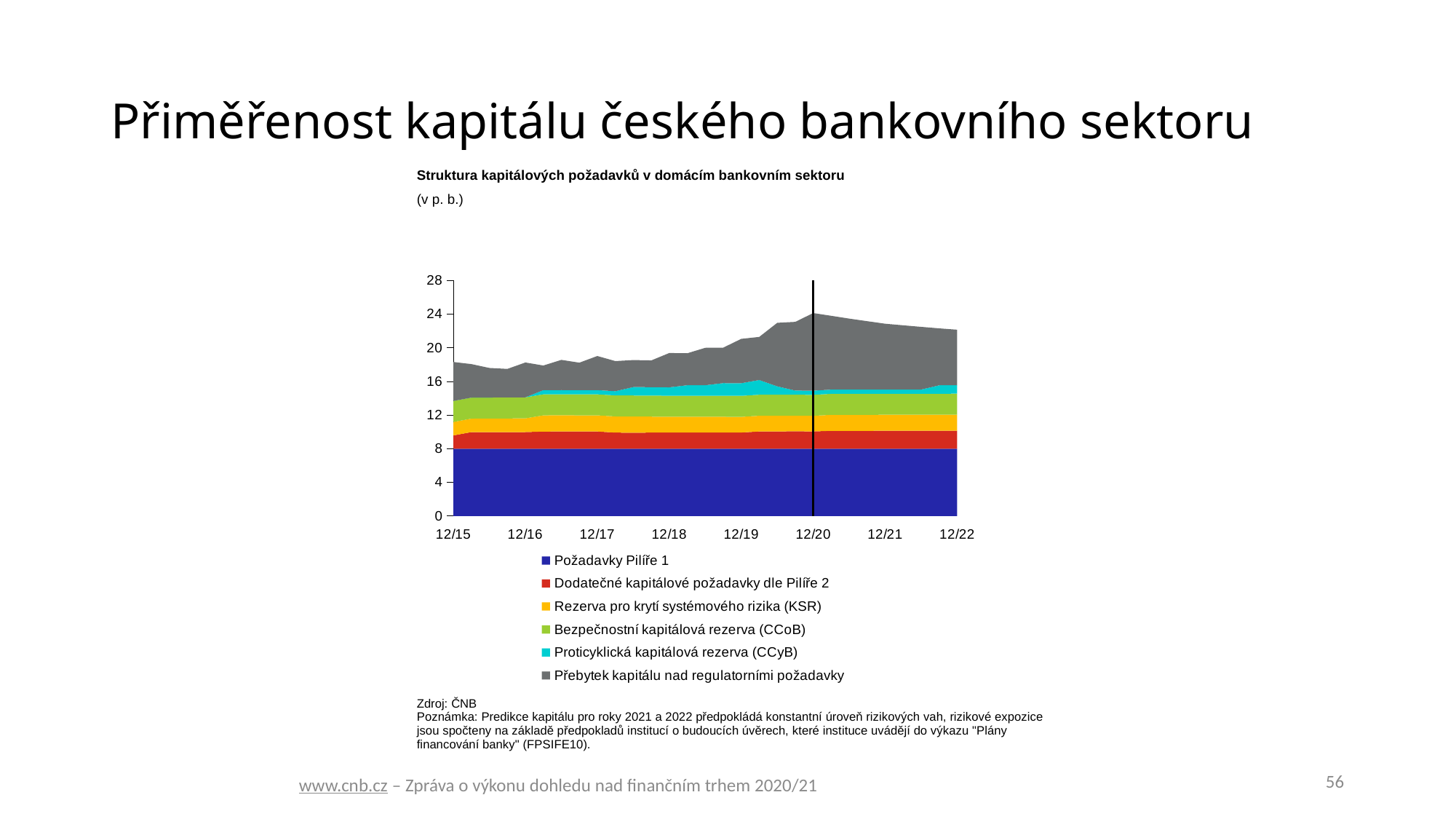
What is the title of the chart? Struktura kapitálových požadavků v domácím bankovním sektoru What kind of chart is shown on the slide? stacked area chart Is the total height of the stacked areas at 12/22 greater or less than 20? greater Does the total height of the stacked areas rise or fall between 12/15 and 12/20? rise How many series does the legend list? 6 Is the total height of the stacked areas at 12/20 greater or less than 20? greater What is the value of Požadavky Pilíře 1 at 12/15? 8 Does the total height of the stacked areas rise or fall between 12/20 and 12/22? fall Which is larger: the total height of the stacked areas at 12/20 or at 12/15? 12/20 Is the total height of the stacked areas at 12/15 greater or less than 20? less In what units are the values expressed, according to the subtitle? v p. b. How many date labels are shown on the x axis? 8